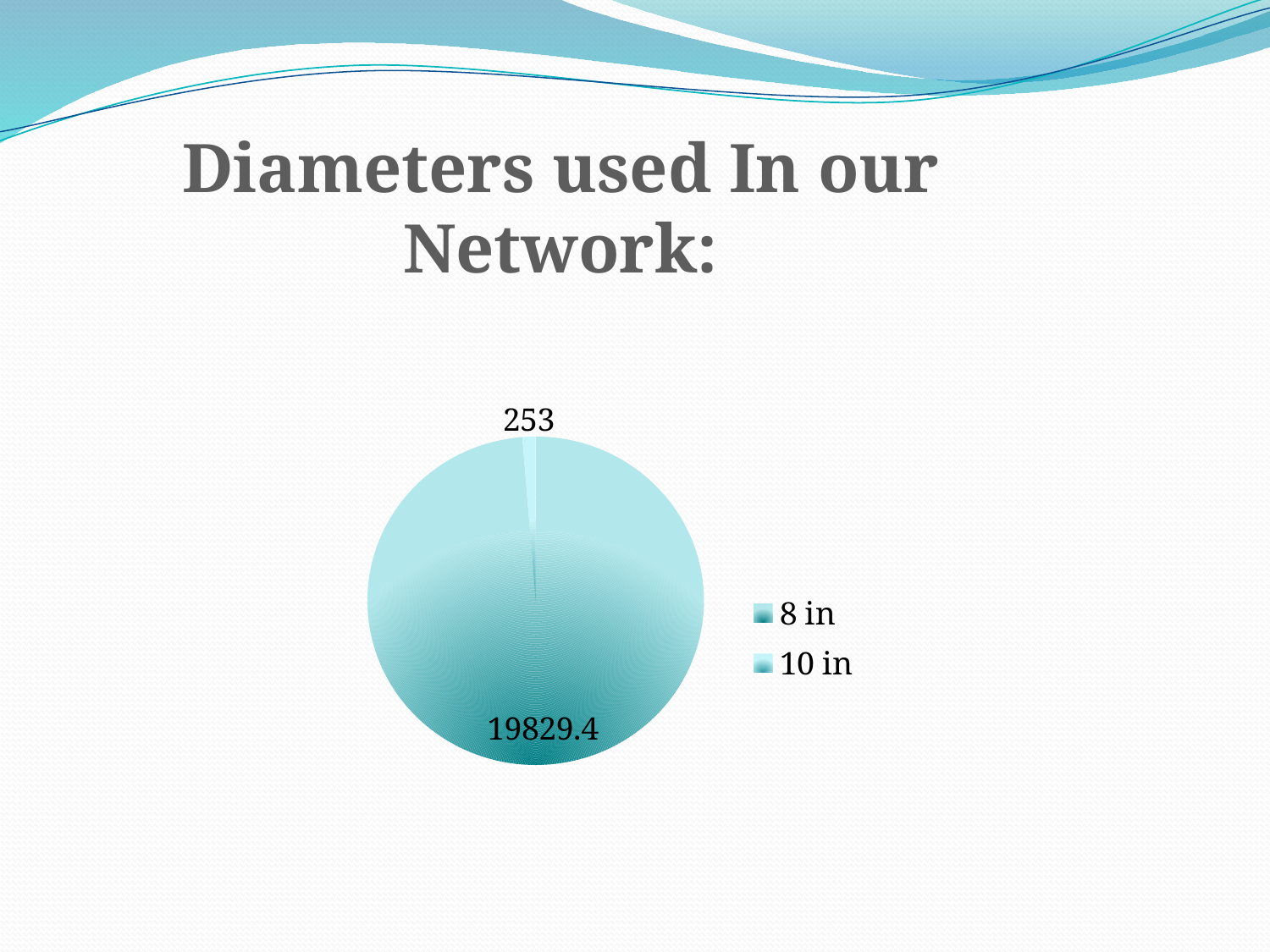
How many entries does the legend list? 2 Which diameter has the smallest slice of the pie? 10 in What type of chart is shown on the slide? pie chart What value is shown for the 8 in slice? 19829.4 What value is shown for the 10 in slice? 253 Which is larger, the value for 8 in or the value for 10 in? 8 in What are the two legend entries of the pie chart? 8 in and 10 in What is the title of the chart slide? Diameters used In our Network: What is the difference between the 8 in value and the 10 in value? 19576.4 How many slices does the pie chart have? 2 Which diameter has the largest slice of the pie? 8 in What is the total of the two values shown in the pie chart? 20082.4